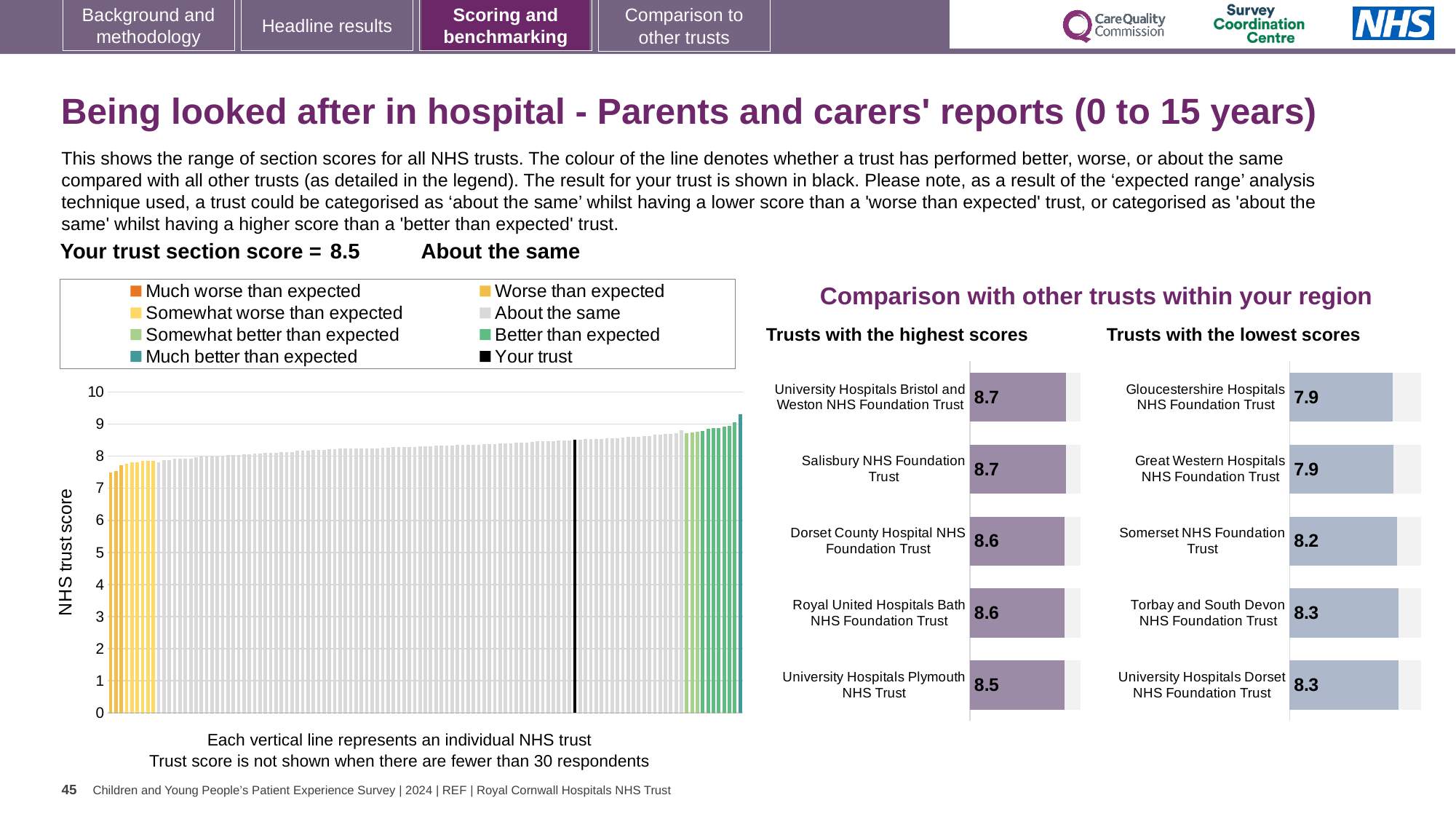
In the large chart on the left, do the trust scores rise or fall from left to right? Rise In the 'Trusts with the lowest scores' chart, what is the score for Somerset NHS Foundation Trust? 8.2 In the 'Trusts with the highest scores' chart, what is the score for Dorset County Hospital NHS Foundation Trust? 8.6 In the large chart on the left, is the value of the leftmost (lowest) bar greater or less than 8? less In the 'Trusts with the highest scores' chart, what is the score for University Hospitals Plymouth NHS Trust? 8.5 How many entries does the legend above the large chart on the left list? 8 What kind of chart is the large chart on the left showing NHS trust scores? Bar chart How many trusts are listed in the 'Trusts with the lowest scores' chart? 5 In the 'Trusts with the highest scores' chart, which trust has the lowest score? University Hospitals Plymouth NHS Trust In the 'Trusts with the lowest scores' chart, what is the difference between the scores of Somerset NHS Foundation Trust and Great Western Hospitals NHS Foundation Trust? 0.3 In the 'Trusts with the highest scores' chart, which has the larger score: Royal United Hospitals Bath NHS Foundation Trust or University Hospitals Plymouth NHS Trust? Royal United Hospitals Bath NHS Foundation Trust In the 'Trusts with the lowest scores' chart, what is the score for Gloucestershire Hospitals NHS Foundation Trust? 7.9